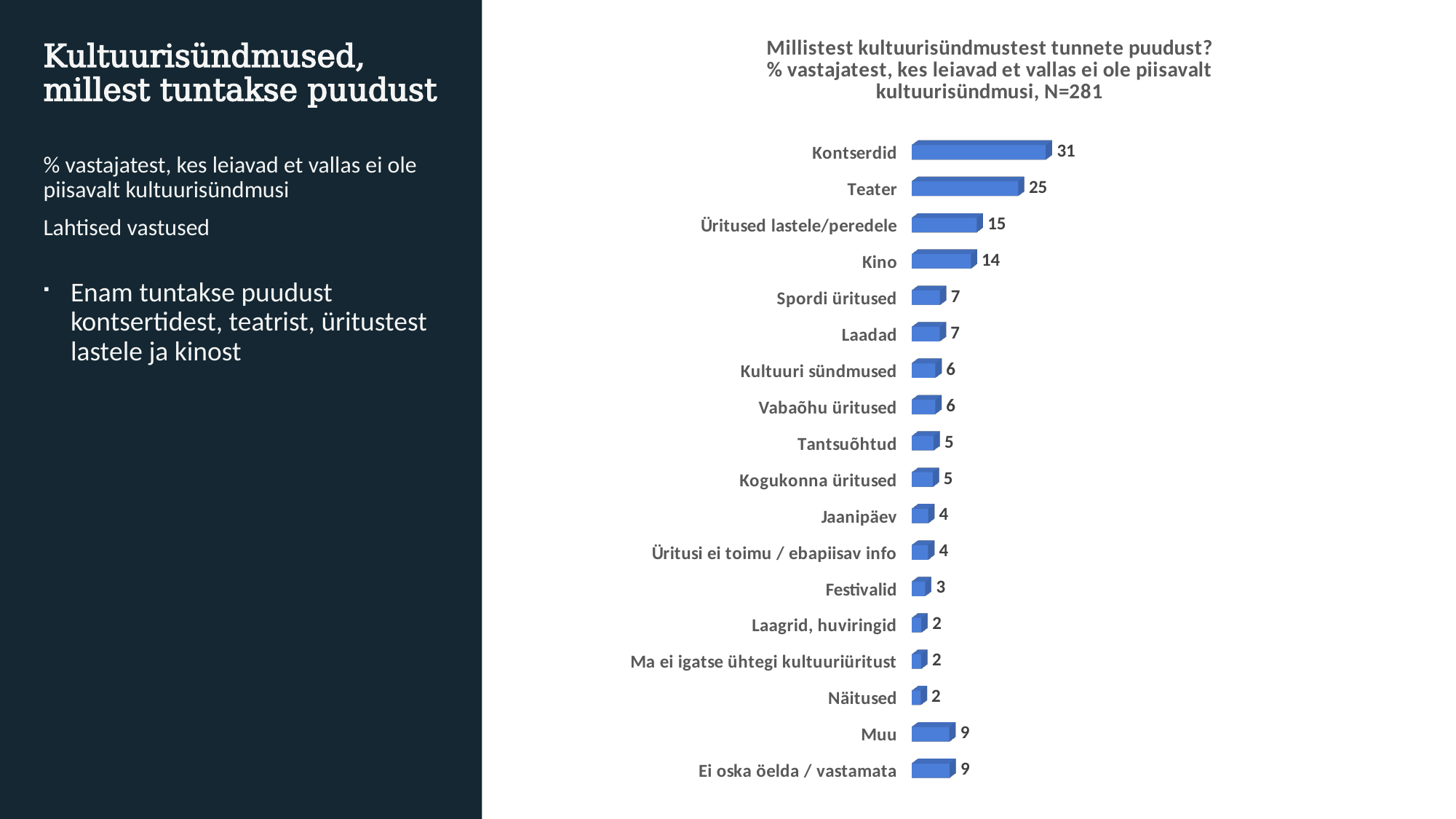
What is the difference between the values for Kontserdid and Teater? 6 What is the value for Festivalid? 3 Which is larger, the value for Jaanipäev or the value for Spordi üritused? Spordi üritused Which category has the highest value? Kontserdid What is the value for Kino? 14 What is the value for Kontserdid? 31 What kind of chart is shown on the slide? Bar chart What is the N value stated in the chart title? N=281 Which is larger, the value for Teater or the value for Muu? Teater What is the difference between the values for Üritused lastele/peredele and Kino? 1 How many categories are shown in the chart? 18 What is the value for Ei oska öelda / vastamata? 9